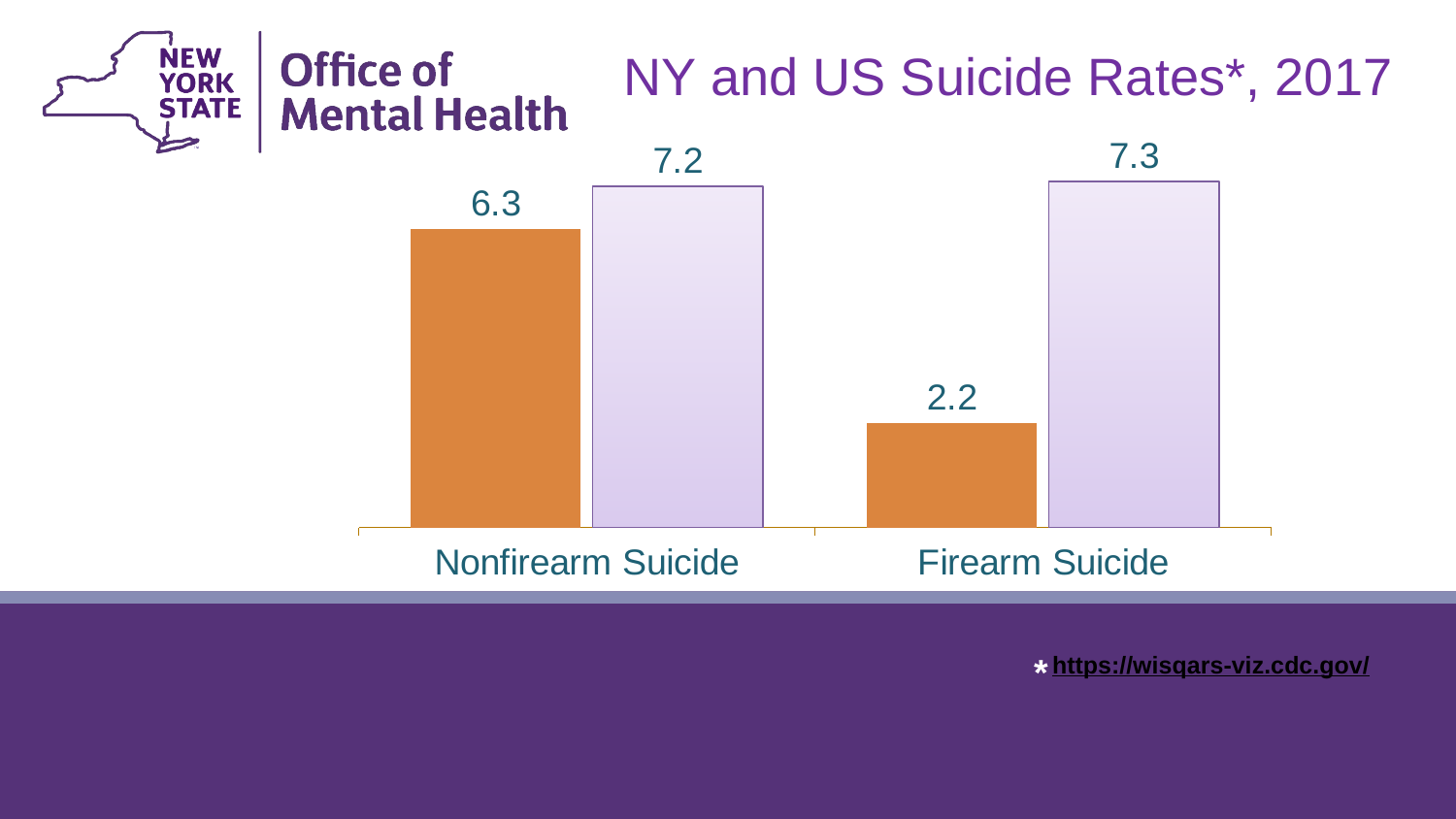
What is the value of the light purple bar for Firearm Suicide? 7.3 Which is larger: the orange bar for Nonfirearm Suicide or the orange bar for Firearm Suicide? Nonfirearm Suicide Which bar on the chart has the highest value? Light purple bar for Firearm Suicide (7.3) What kind of chart is shown on the slide? Bar chart What is the title of the chart? NY and US Suicide Rates*, 2017 What is the difference between the light purple and orange bars for Nonfirearm Suicide? 0.9 What is the value of the orange bar for Nonfirearm Suicide? 6.3 Which bar on the chart has the lowest value? Orange bar for Firearm Suicide (2.2) What is the value of the orange bar for Firearm Suicide? 2.2 What is the difference between the light purple and orange bars for Firearm Suicide? 5.1 How many categories are shown on the x axis? 2 What is the value of the light purple bar for Nonfirearm Suicide? 7.2